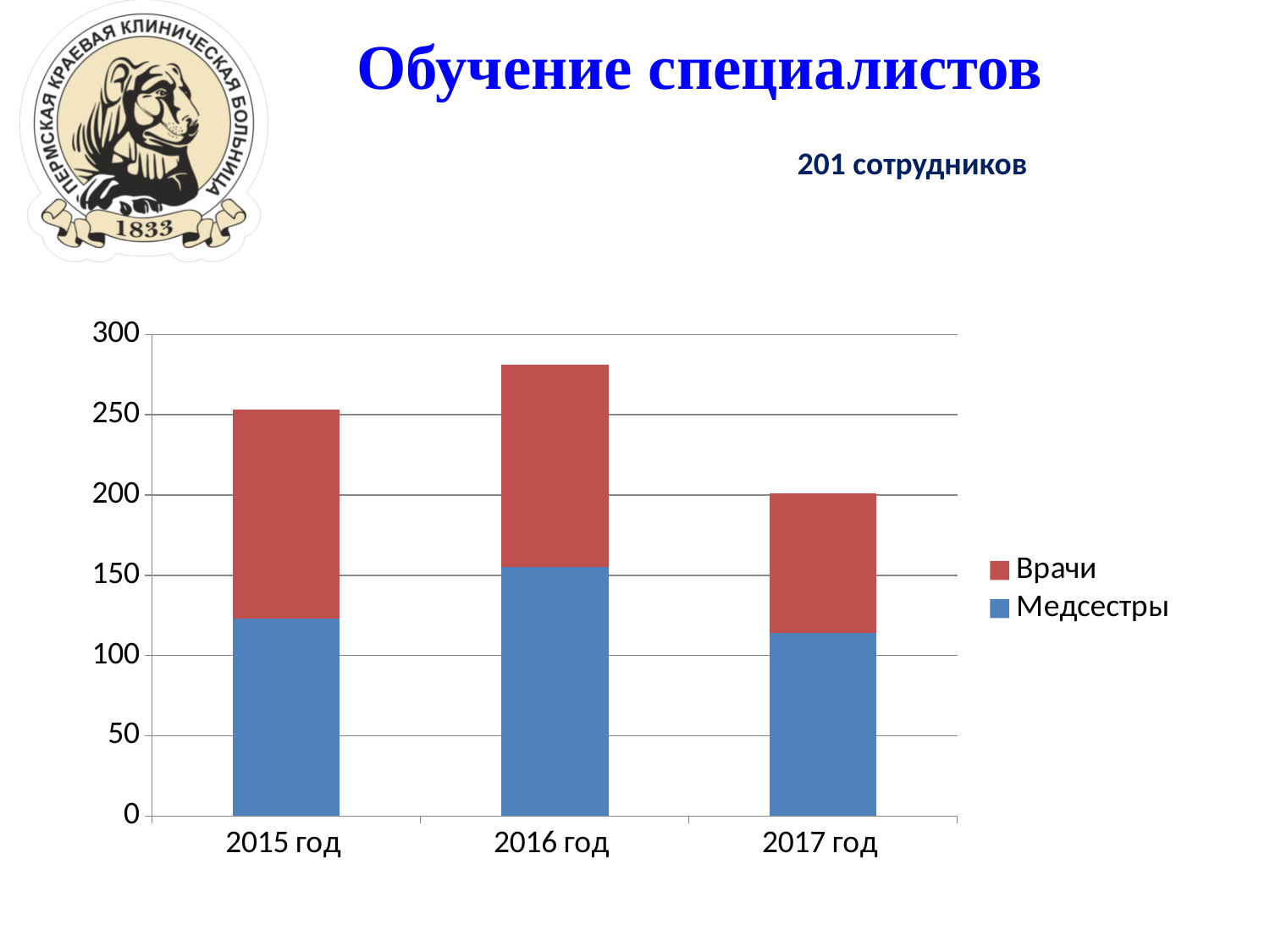
Which colour represents the Врачи series in the legend? Red How many year categories are shown on the x axis? 3 Is the total bar for 2017 год greater or less than 250? less How many series does the chart legend list? 2 What kind of chart is shown on the slide? Stacked bar chart Is the total bar for 2016 год greater or less than 250? greater Which year has the highest total bar? 2016 год Does the total bar rise or fall from 2016 год to 2017 год? fall Is the Медсестры value for 2017 год greater or less than 100? greater Which year has the lowest total bar? 2017 год Which is larger, the Медсестры value for 2016 год or for 2015 год? 2016 год